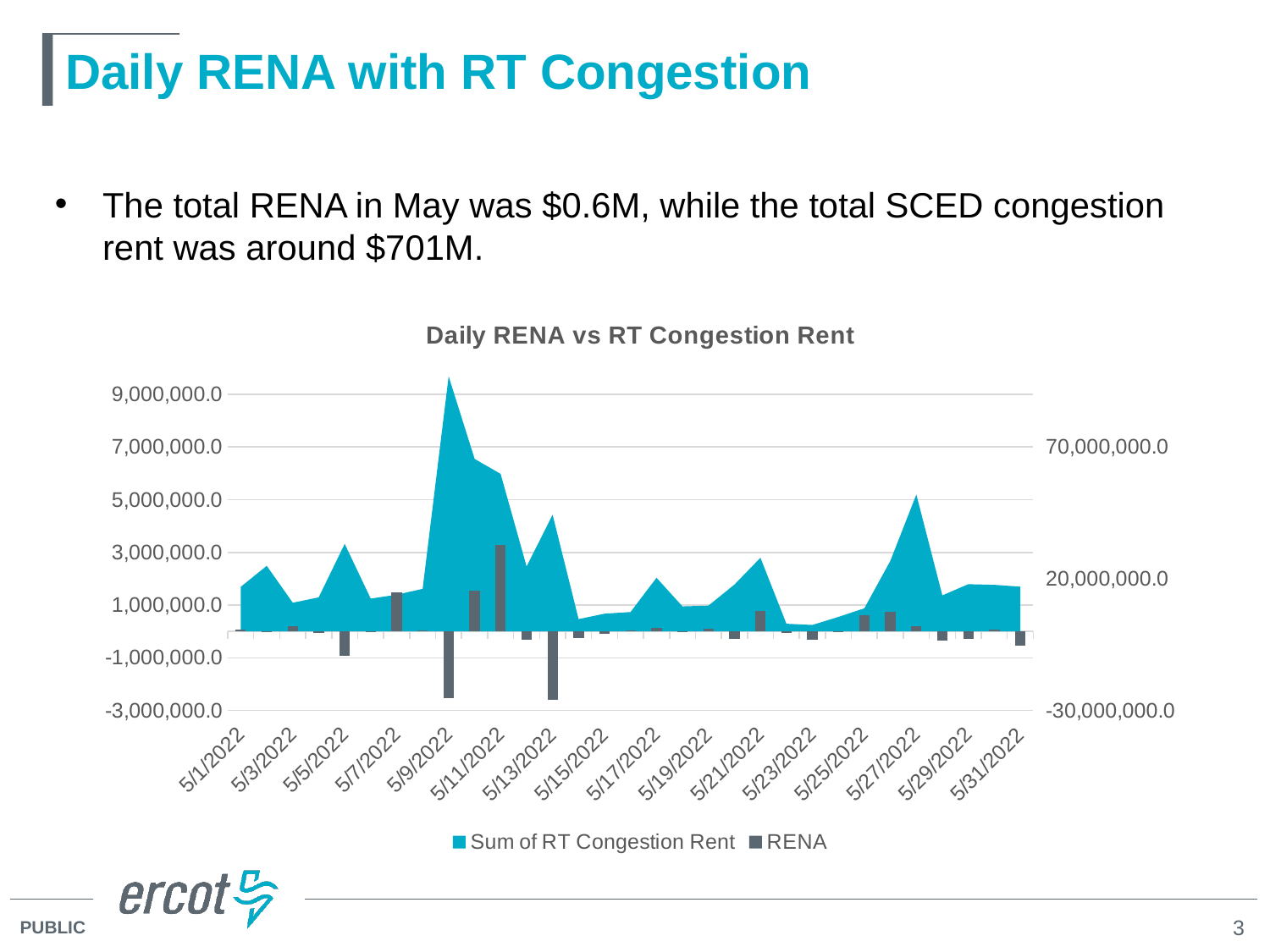
Is the RENA value on 5/11/2022 larger than the RENA value on 5/7/2022? Yes What is the title of the chart? Daily RENA vs RT Congestion Rent How many series does the chart legend list? 2 Is the RENA value for 5/11/2022 greater or less than 1,000,000.0 on the left axis? greater Is the Sum of RT Congestion Rent higher on 5/9/2022 or on 5/27/2022? 5/9/2022 Does the Sum of RT Congestion Rent rise or fall from 5/23/2022 to 5/27/2022? Rise Which series is shown in teal (the shaded area)? Sum of RT Congestion Rent What kind of chart is used to show the RENA series? Bar chart How many date labels are shown on the x axis? 16 On which date does the Sum of RT Congestion Rent reach its highest value? 5/9/2022 Is the RENA value for 5/5/2022 greater or less than 0? less On which date is the RENA bar the tallest positive value? 5/11/2022